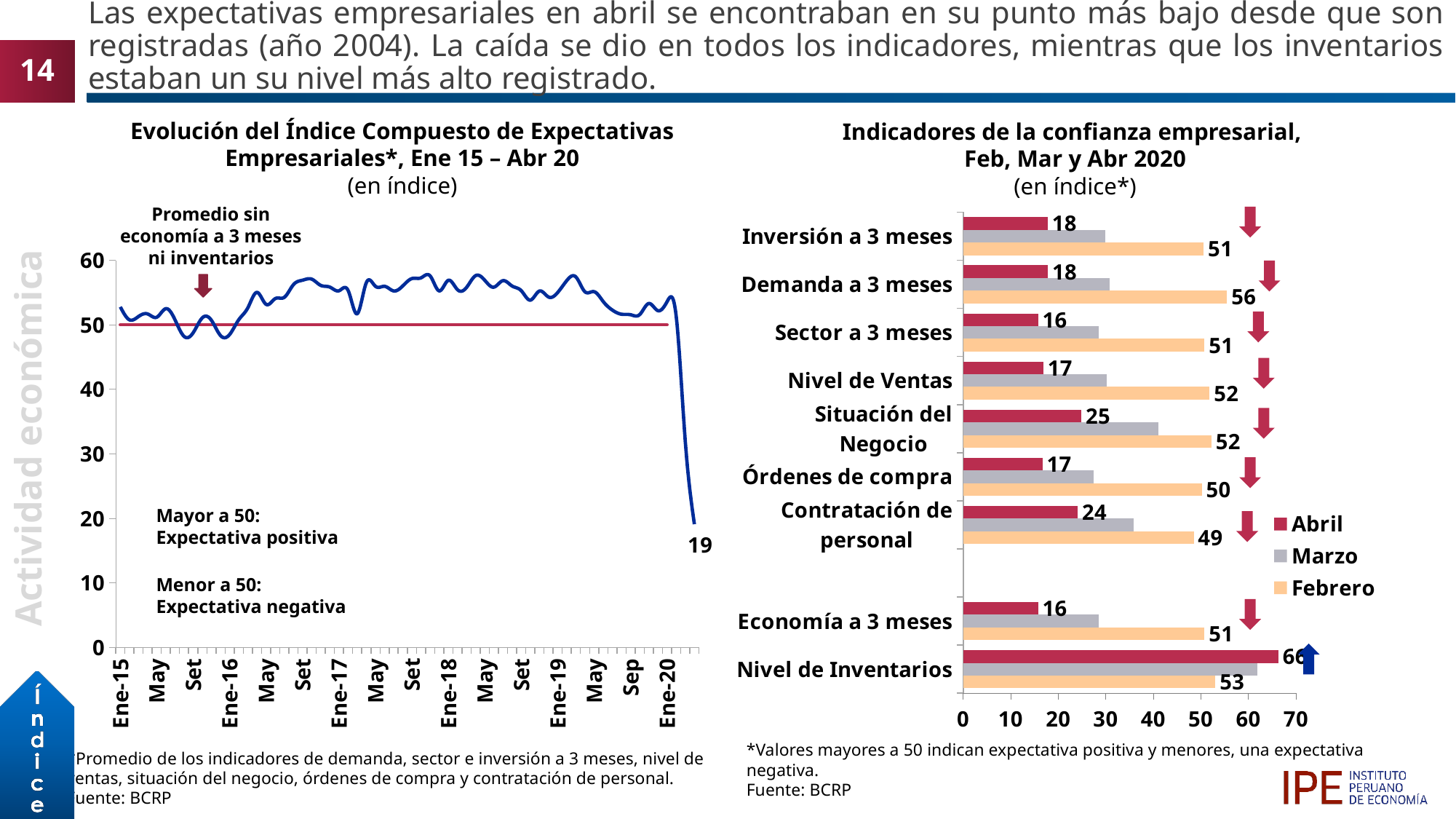
How many series does the legend of the chart 'Indicadores de la confianza empresarial' list? 3 What type of chart is 'Evolución del Índice Compuesto de Expectativas Empresariales'? Line chart In the chart 'Indicadores de la confianza empresarial', what is the difference between the Febrero and Abril values for Inversión a 3 meses? 33 In the chart 'Indicadores de la confianza empresarial', what is the Abril value for Situación del Negocio? 25 In the chart 'Indicadores de la confianza empresarial', which is larger for Contratación de personal: the Abril value or the Febrero value? Febrero In the chart 'Indicadores de la confianza empresarial', which indicator has the highest Abril value? Nivel de Inventarios In the chart 'Indicadores de la confianza empresarial', which colour represents the Abril series? Red In the chart 'Indicadores de la confianza empresarial', is the Marzo value for Nivel de Inventarios greater or less than 50? greater In the chart 'Evolución del Índice Compuesto de Expectativas Empresariales', what is the value labeled at the end of the series (Abr 20)? 19 How many indicators (categories) are shown in the chart 'Indicadores de la confianza empresarial'? 9 In the chart 'Indicadores de la confianza empresarial', what is the Febrero value for Demanda a 3 meses? 56 In the chart 'Indicadores de la confianza empresarial', what is the Abril value for Nivel de Inventarios? 66